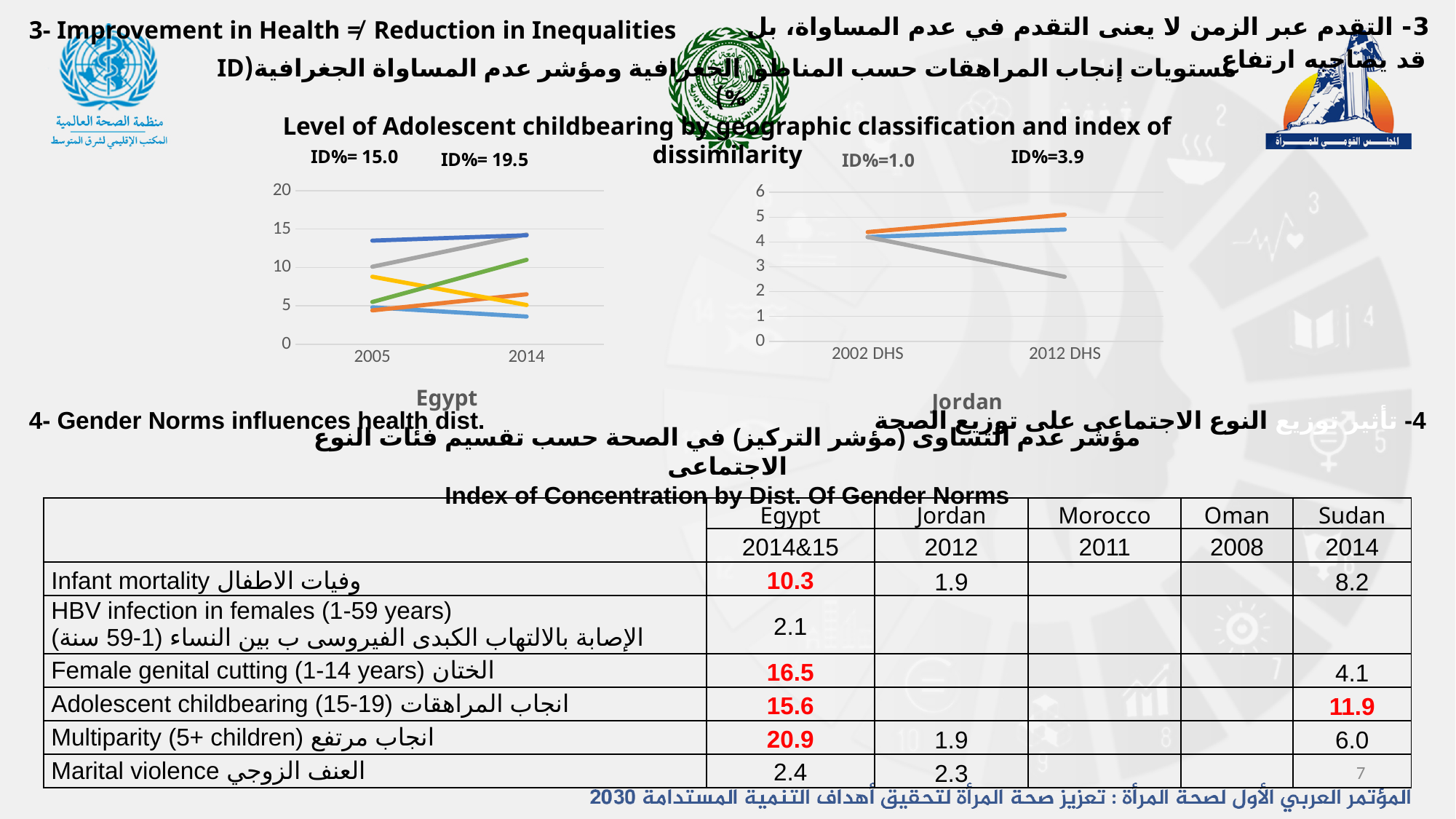
What kind of chart is the Egypt chart on the slide? line chart In the Jordan chart, how many lines are plotted? 3 In the Jordan chart, what are the two x-axis labels? 2002 DHS and 2012 DHS What ID% value is printed above the Jordan chart for 2002 DHS? 1.0 What ID% value is printed above the Egypt chart for 2014? 19.5 By how much did the printed ID% for Egypt change between 2005 (15.0) and 2014 (19.5)? 4.5 Which chart shows the higher ID% at its later time point, Egypt (19.5) or Jordan (3.9)? Egypt In the Egypt chart, how many points are shown on the x axis? 2 In the Jordan chart, does the gray line rise or fall from 2002 DHS to 2012 DHS? fall What kind of chart is the Jordan chart on the slide? line chart In the Jordan chart, is the value of the gray line at 2012 DHS greater or less than 3? less In the Egypt chart, how many lines are plotted? 6